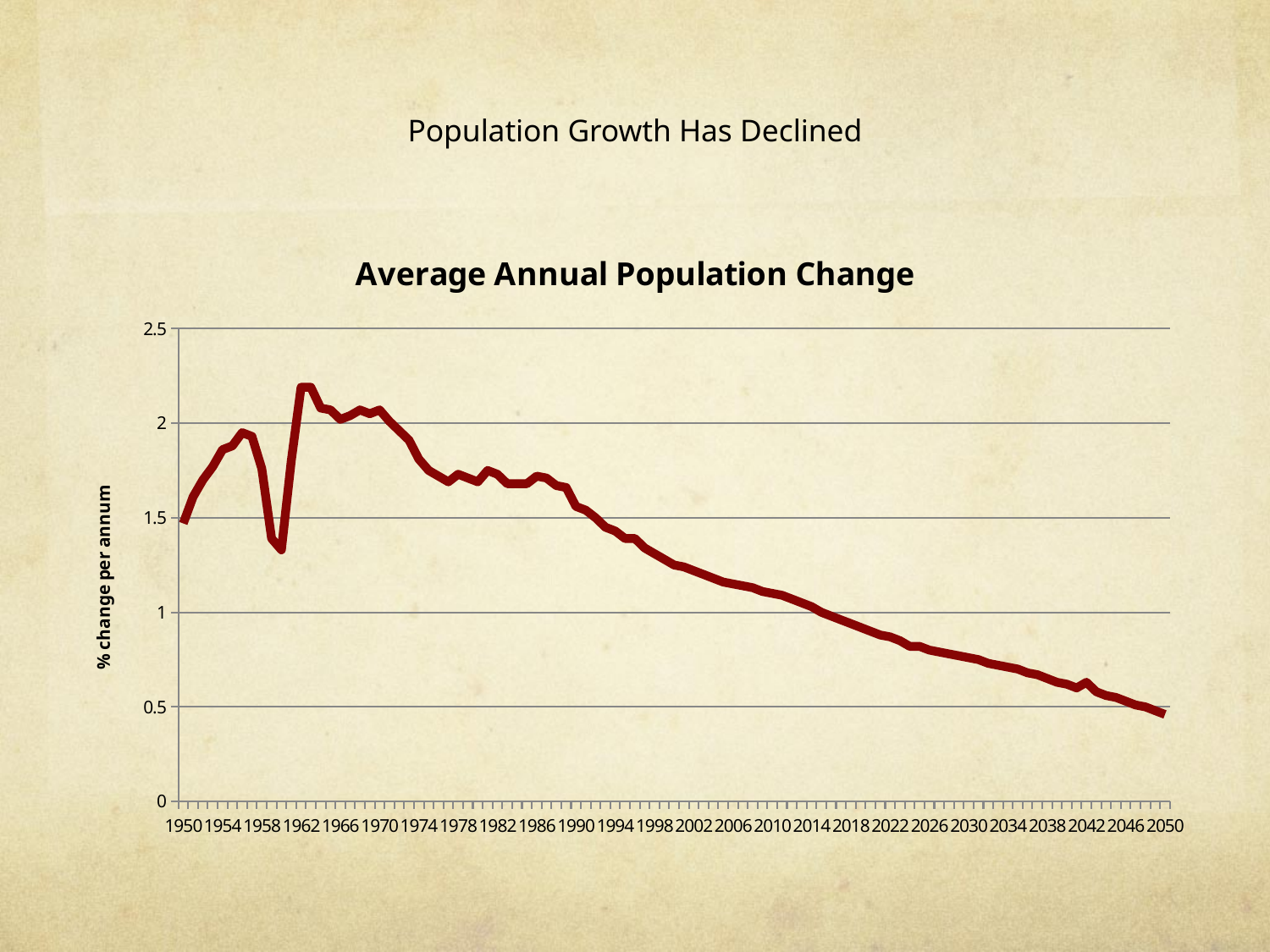
Is the value for 1960 greater or less than 1.5? less In which year does the line reach its highest value? 1962 Which year has the larger value, 1950 or 2050? 1950 Overall, do the values rise or fall from 1962 to 2050? fall What is the label on the vertical axis of the chart? % change per annum In which year does the line reach its lowest value? 2050 Which year has the larger value, 2010 or 2030? 2010 Is the value for 2030 greater or less than 1? less What kind of chart is shown on the slide? line chart Is the value for 1962 greater or less than 2? greater What is the title of the chart? Average Annual Population Change